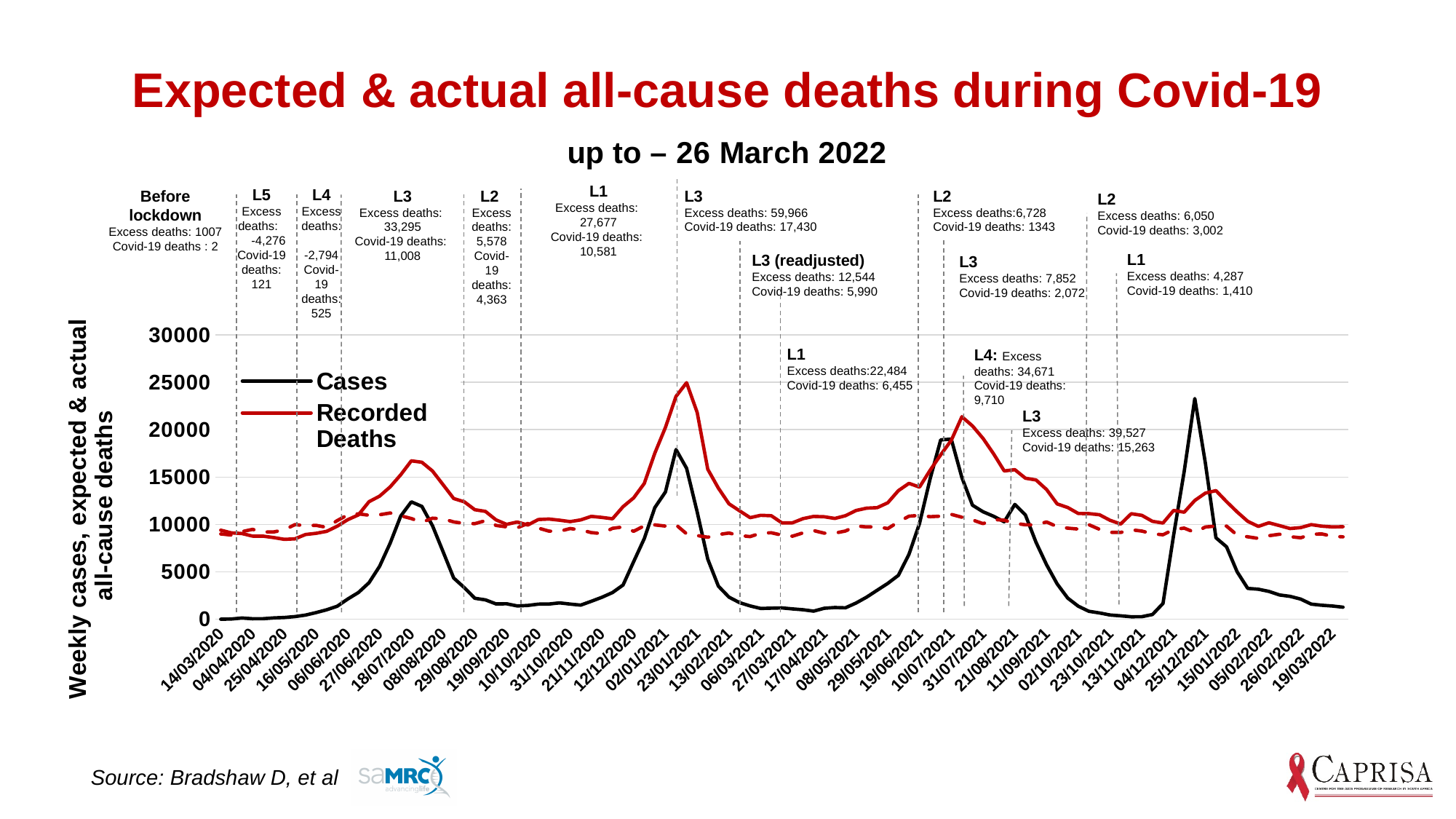
What kind of chart is shown on the slide? Line chart What are the two series named in the chart legend? Cases and Recorded Deaths Which is larger: the Recorded Deaths peak around 23/01/2021 or the Recorded Deaths peak around 18/07/2020? The peak around 23/01/2021 Which lockdown period annotation shows the lowest number of excess deaths? L5 (-4,276) What is the y-axis title of the chart? Weekly cases, expected & actual all-cause deaths Is the peak of the Cases line around 25/12/2021 greater or less than 20000? greater How many series does the chart legend list? 2 What is the difference between excess deaths and Covid-19 deaths in the L3 period annotated with 59,966 excess deaths? 42,536 Which lockdown period annotation shows the highest number of excess deaths? L3 (59,966) Is the peak of the Recorded Deaths line around 23/01/2021 greater or less than 20000? greater According to the annotation, how many Covid-19 deaths were recorded in the L3 period with 59,966 excess deaths? 17,430 According to the annotation, how many excess deaths were recorded during the first L3 period (after L4)? 33,295